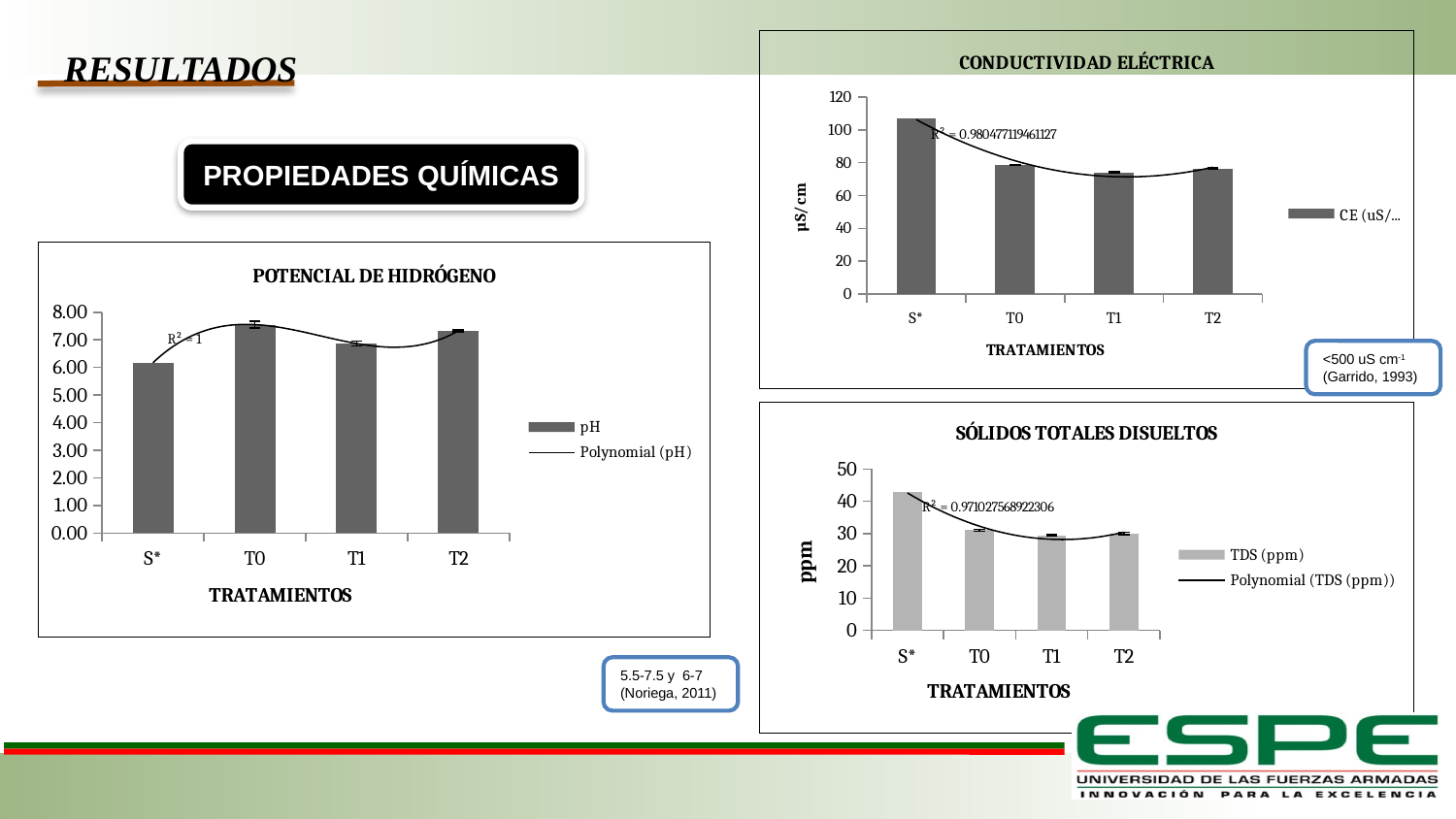
In the CONDUCTIVIDAD ELÉCTRICA chart, is the value for S* greater or less than 100? greater In the CONDUCTIVIDAD ELÉCTRICA chart, which is larger, the value for S* or for T0? S* In the CONDUCTIVIDAD ELÉCTRICA chart, which treatment has the highest value? S* In the SÓLIDOS TOTALES DISUELTOS chart, is the value for S* greater or less than 40? greater In the POTENCIAL DE HIDRÓGENO chart, is the pH value for S* greater or less than 7.00? less What kind of chart is the CONDUCTIVIDAD ELÉCTRICA chart? bar chart In the POTENCIAL DE HIDRÓGENO chart, which treatment has the highest pH value? T0 In the POTENCIAL DE HIDRÓGENO chart, which is larger, the pH value for T0 or for S*? T0 How many treatments are shown on the x axis of the SÓLIDOS TOTALES DISUELTOS chart? 4 In the POTENCIAL DE HIDRÓGENO chart, which treatment has the lowest pH value? S* In the SÓLIDOS TOTALES DISUELTOS chart, which treatment has the highest TDS value? S* How many entries does the legend of the POTENCIAL DE HIDRÓGENO chart list? 2